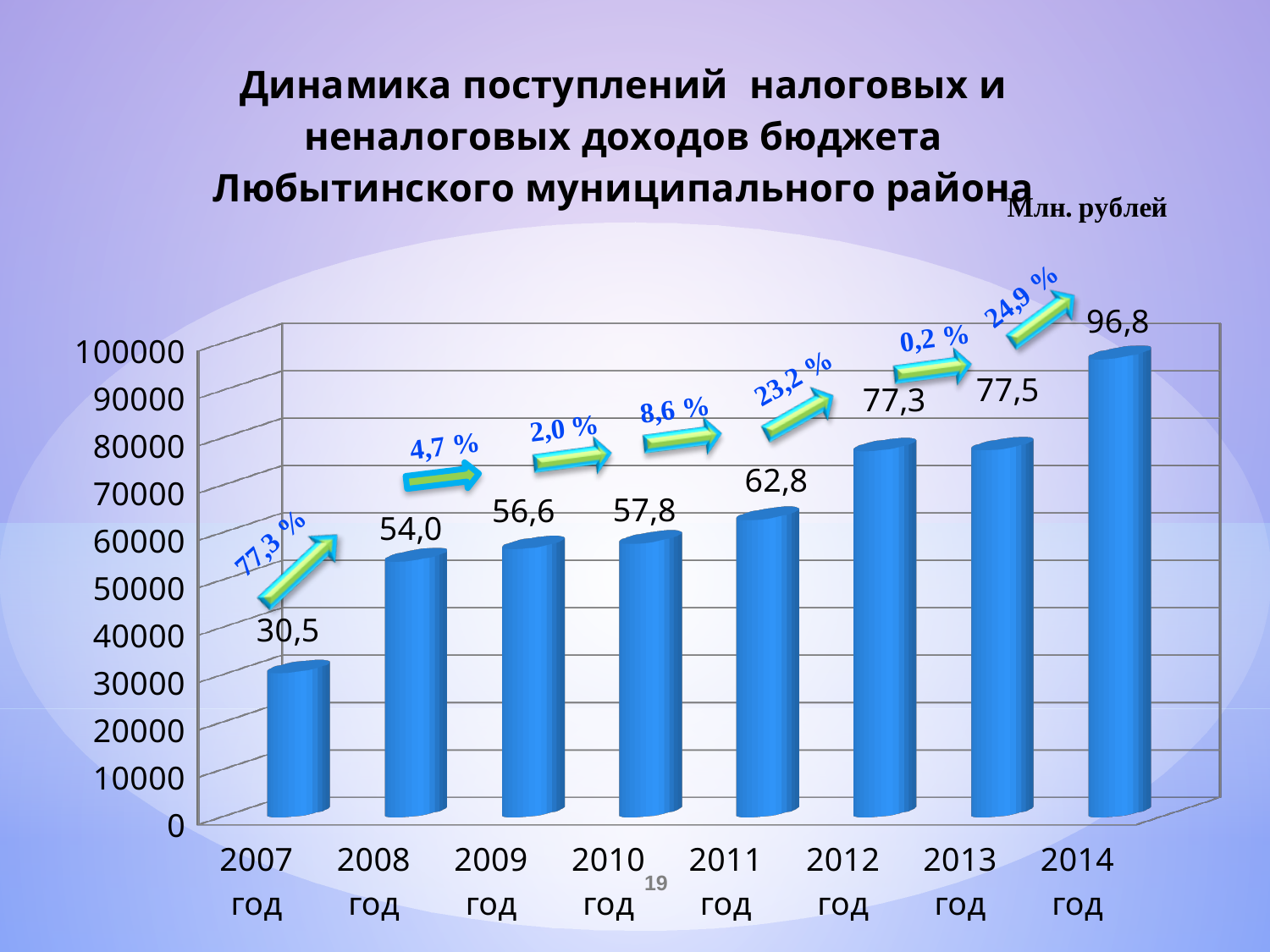
What is the value for 2007 год? 30,5 Which year has the lowest value? 2007 год Which year has the highest value? 2014 год What is the value for 2011 год? 62,8 What is the difference between the values for 2008 год and 2007 год? 23,5 How many years are shown on the x axis? 8 Is the bar for 2007 год greater or less than 40000 on the axis? less What is the difference between the values for 2014 год and 2013 год? 19,3 What is the value for 2014 год? 96,8 Which is larger, the value for 2012 год or the value for 2011 год? 2012 год Do the values rise or fall from 2007 год to 2014 год? rise What kind of chart is shown on the slide? bar chart